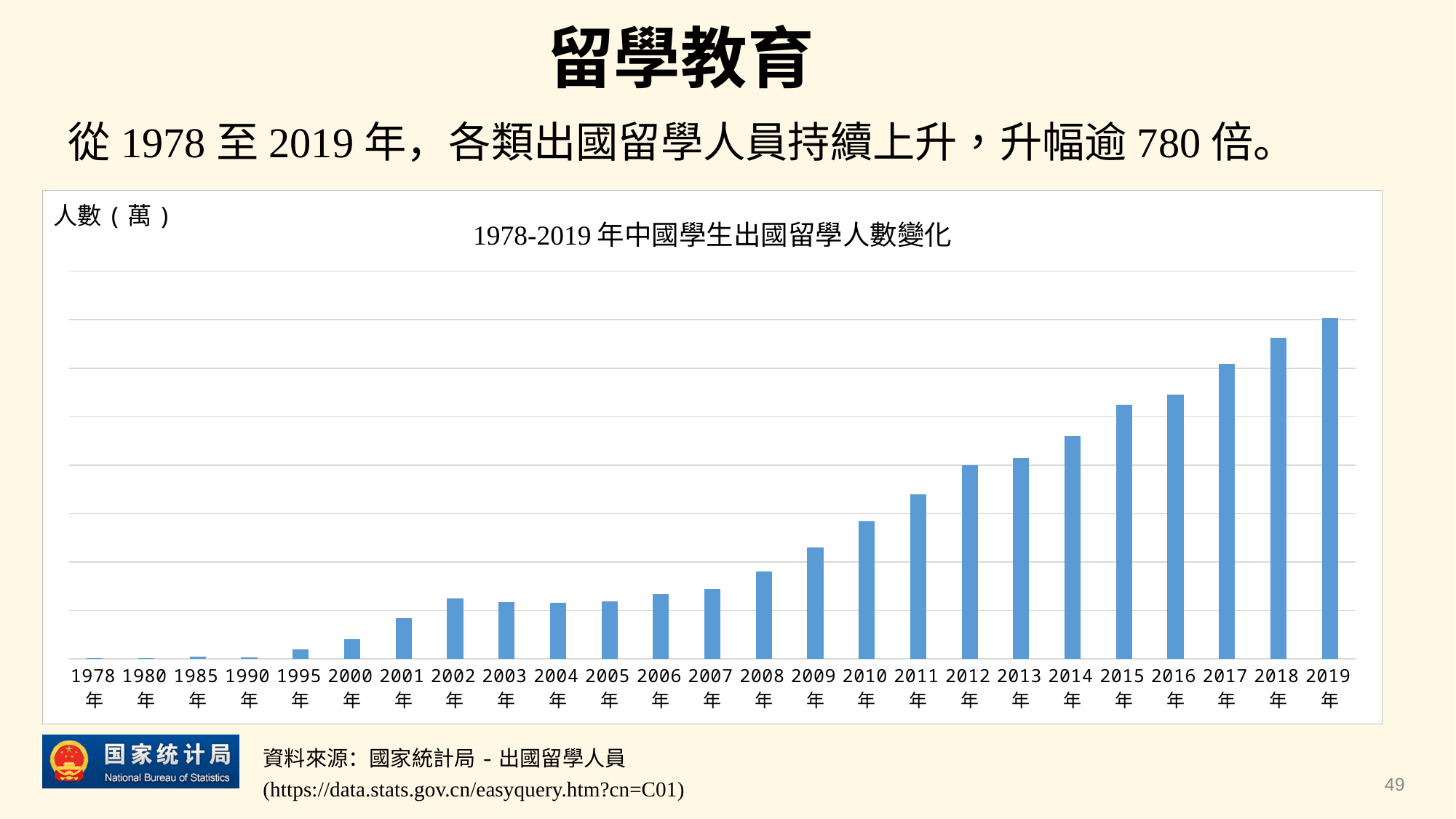
Overall, do the values rise or fall from 1978 年 to 2019 年? Rise Which year is the first category on the x axis of the chart? 1978 年 What unit label is shown at the top left of the chart's vertical axis? 人數（萬） Which is larger, the value for 2002 年 or the value for 2004 年? 2002 年 Which year has the highest bar in the chart? 2019 年 Is the bar for 2019 年 taller or shorter than the bar for 2018 年? Taller What is the title of the chart? 1978-2019 年中國學生出國留學人數變化 Which is larger, the value for 2000 年 or the value for 1995 年? 2000 年 What kind of chart is shown on the slide? Bar chart How many years (bars) are plotted in the chart? 25